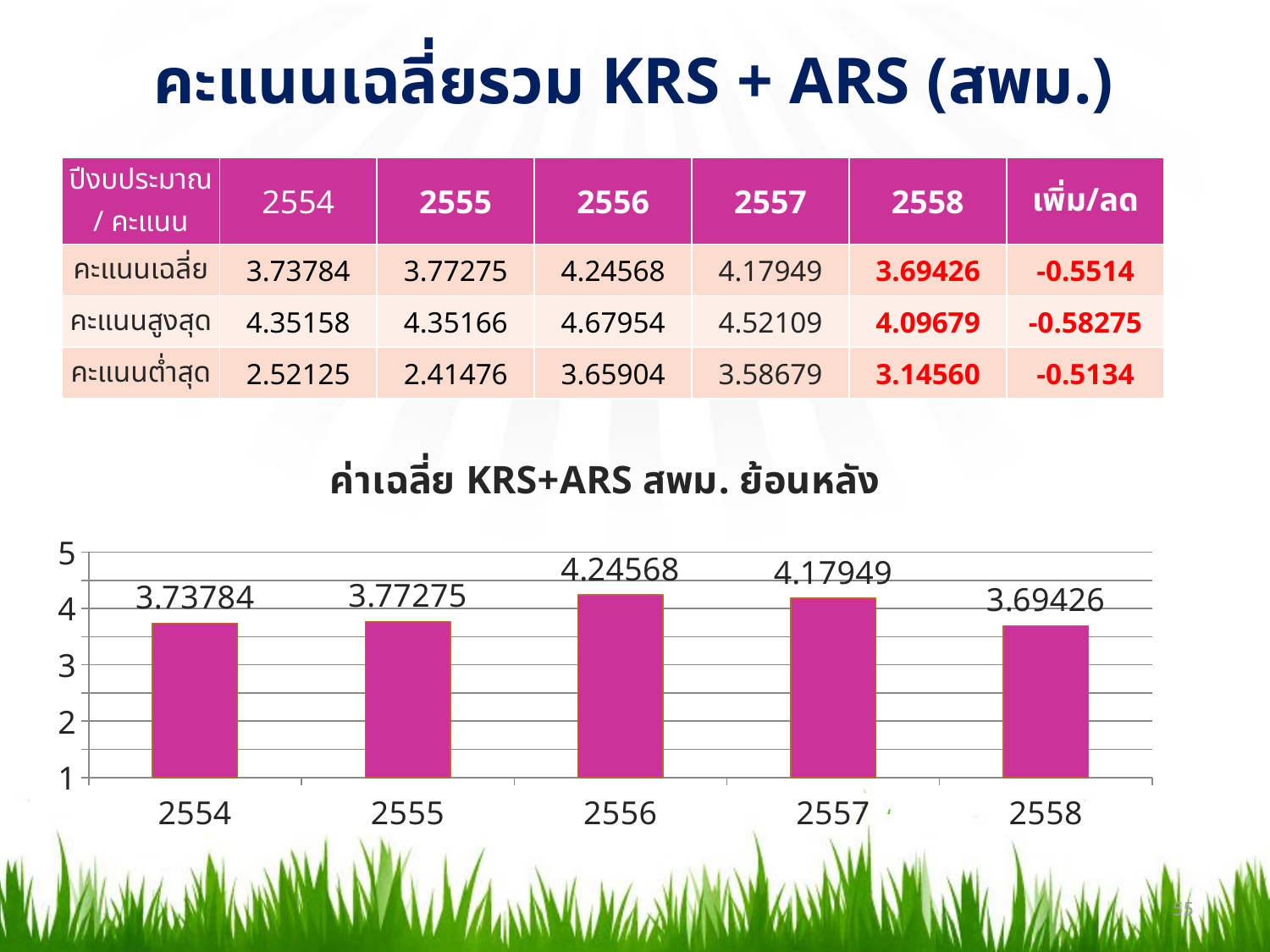
Is the value for 2556 in the chart greater or less than 4? greater Which is larger in the chart, the value for 2554 or the value for 2555? 2555 What is the value for 2558 in the chart? 3.69426 What is the difference between the values for 2556 and 2557 in the chart? 0.06619 What is the difference between the values for 2556 and 2558 in the chart? 0.55142 What is the value for 2554 in the chart? 3.73784 What is the value for 2556 in the chart? 4.24568 Which year has the lowest value in the chart? 2558 How many years are shown on the x axis of the chart? 5 What kind of chart is shown on the slide? bar chart What is the title of the chart? ค่าเฉลี่ย KRS+ARS สพม. ย้อนหลัง Which year has the highest value in the chart? 2556